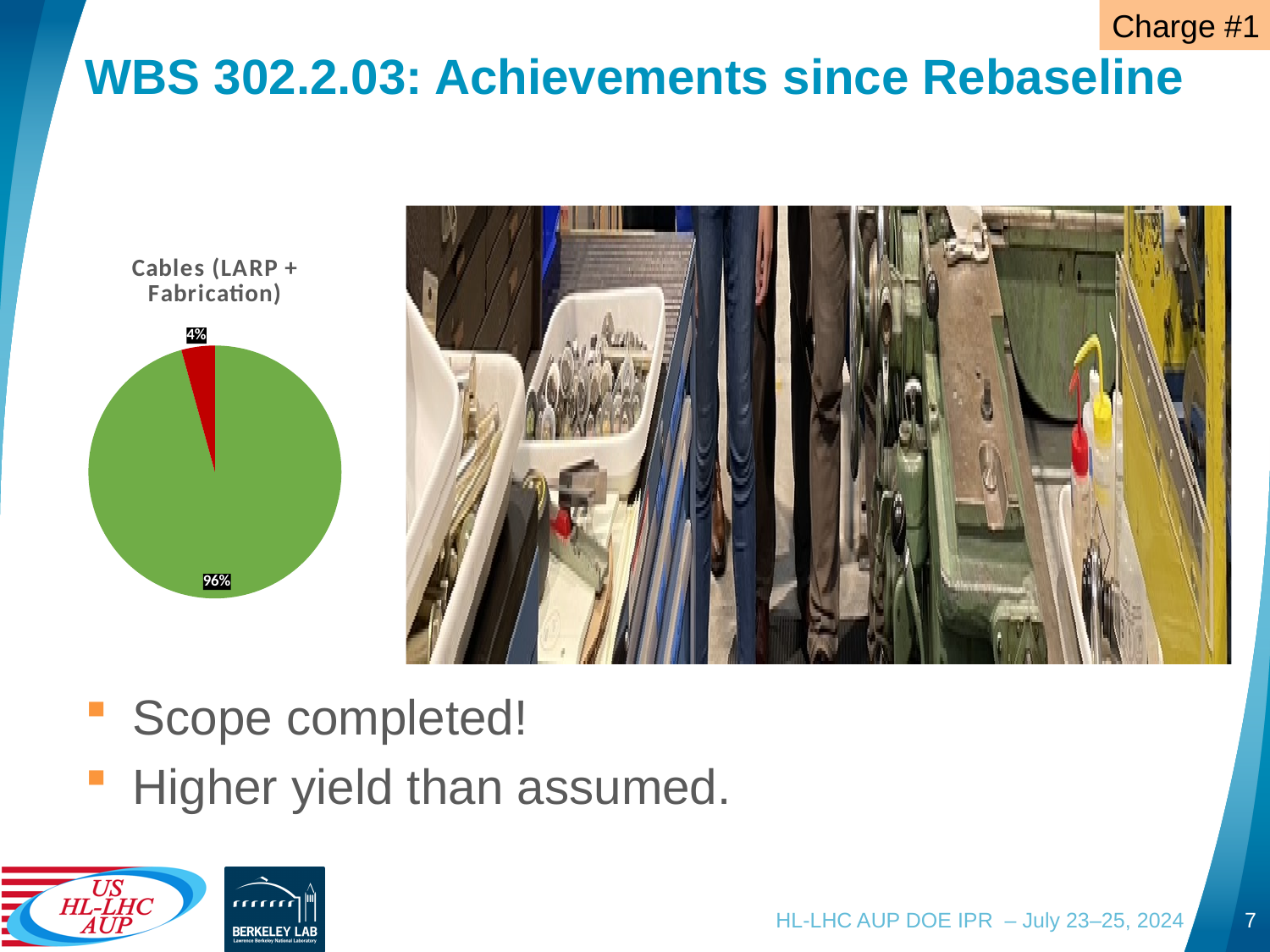
What is the difference in percentage points between the green slice and the red slice? 92 What kind of chart is shown on the slide? pie chart Which slice of the pie chart is the largest? the green slice (96%) Is the green slice larger or smaller than the red slice? larger Do the two slice percentages in the pie chart add up to 100%? yes How many slices does the pie chart have? 2 Which slice of the pie chart is the smallest? the red slice (4%) What colour is the slice labelled 4%? red What is the title of the pie chart? Cables (LARP + Fabrication) What share of the pie does the green slice represent? 96% What share of the pie does the red slice represent? 4%